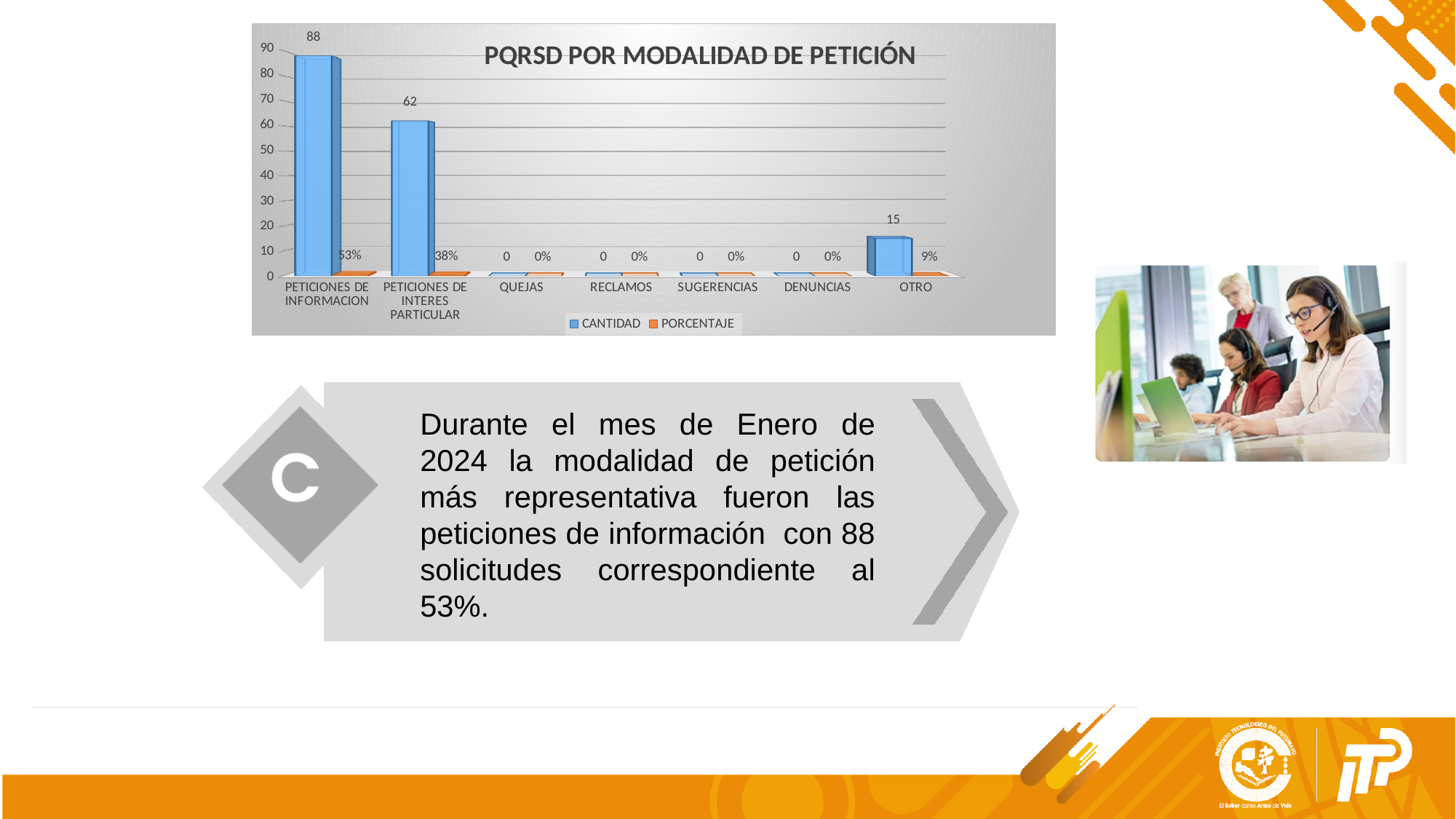
What is the title of the chart? PQRSD POR MODALIDAD DE PETICIÓN What is the PORCENTAJE value for PETICIONES DE INTERES PARTICULAR? 38% Which category has the highest CANTIDAD value? PETICIONES DE INFORMACION Which is larger, the CANTIDAD value for PETICIONES DE INTERES PARTICULAR or for OTRO? PETICIONES DE INTERES PARTICULAR What is the PORCENTAJE value for OTRO? 9% What is the CANTIDAD value for PETICIONES DE INTERES PARTICULAR? 62 How many categories are shown on the x axis? 7 What is the difference between the CANTIDAD values for PETICIONES DE INFORMACION and PETICIONES DE INTERES PARTICULAR? 26 How many series does the legend list? 2 What kind of chart is shown? Bar chart What is the CANTIDAD value for QUEJAS? 0 What is the CANTIDAD value for PETICIONES DE INFORMACION? 88